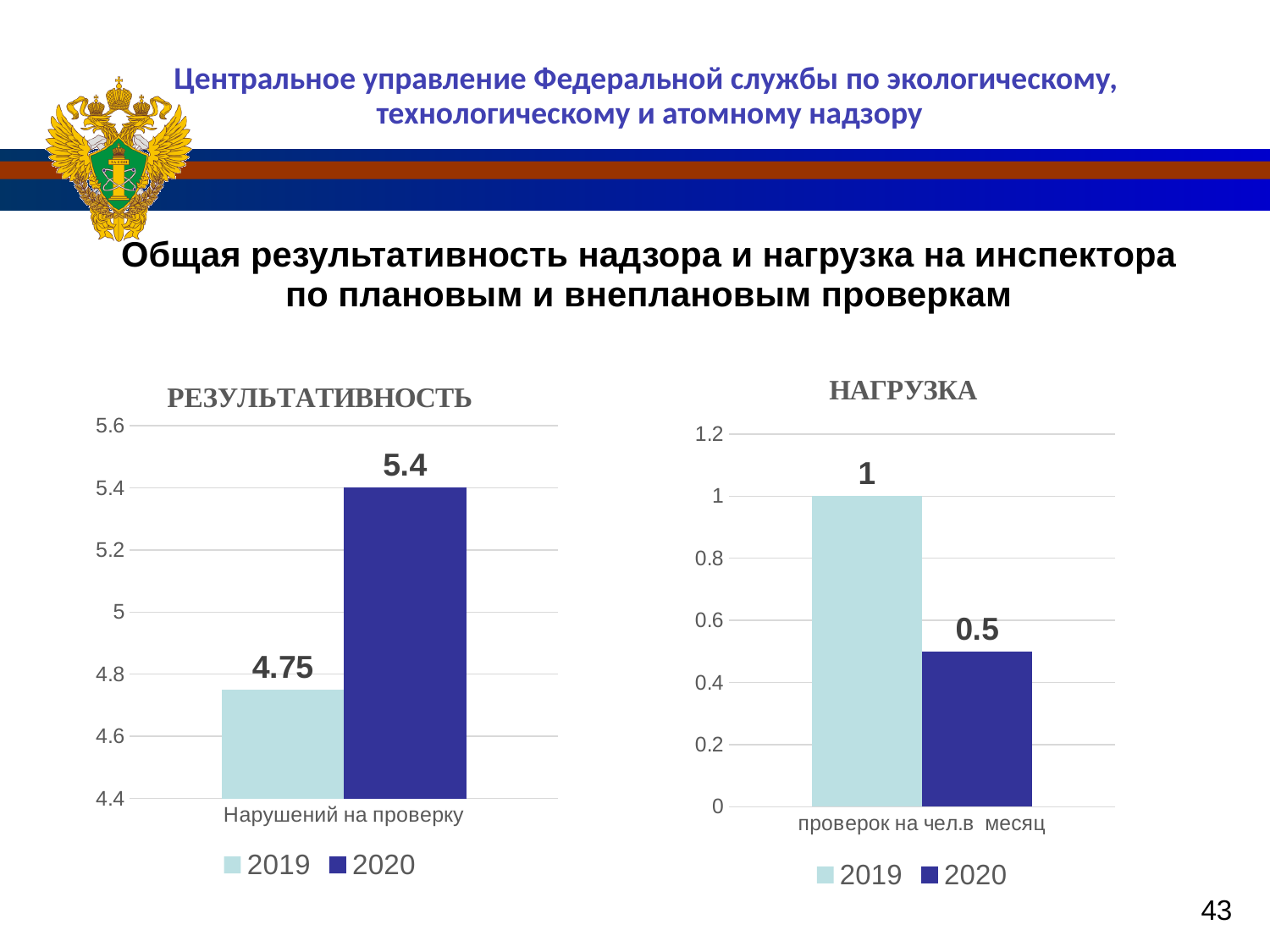
In the РЕЗУЛЬТАТИВНОСТЬ chart, what is the value for 2020? 5.4 In the НАГРУЗКА chart, is the value for 2019 larger or smaller than the value for 2020? larger What is the category label on the x axis of the РЕЗУЛЬТАТИВНОСТЬ chart? Нарушений на проверку In the РЕЗУЛЬТАТИВНОСТЬ chart, which year has the higher value? 2020 In the РЕЗУЛЬТАТИВНОСТЬ chart, what is the difference between the 2020 and 2019 values? 0.65 In the РЕЗУЛЬТАТИВНОСТЬ chart, what is the value for 2019? 4.75 In the НАГРУЗКА chart, what is the difference between the 2019 and 2020 values? 0.5 In the НАГРУЗКА chart, what is the value for 2019? 1 In the НАГРУЗКА chart, which year has the lower value? 2020 How many series does the legend of the РЕЗУЛЬТАТИВНОСТЬ chart list? 2 In the НАГРУЗКА chart, what is the value for 2020? 0.5 What kind of chart is the НАГРУЗКА chart? bar chart